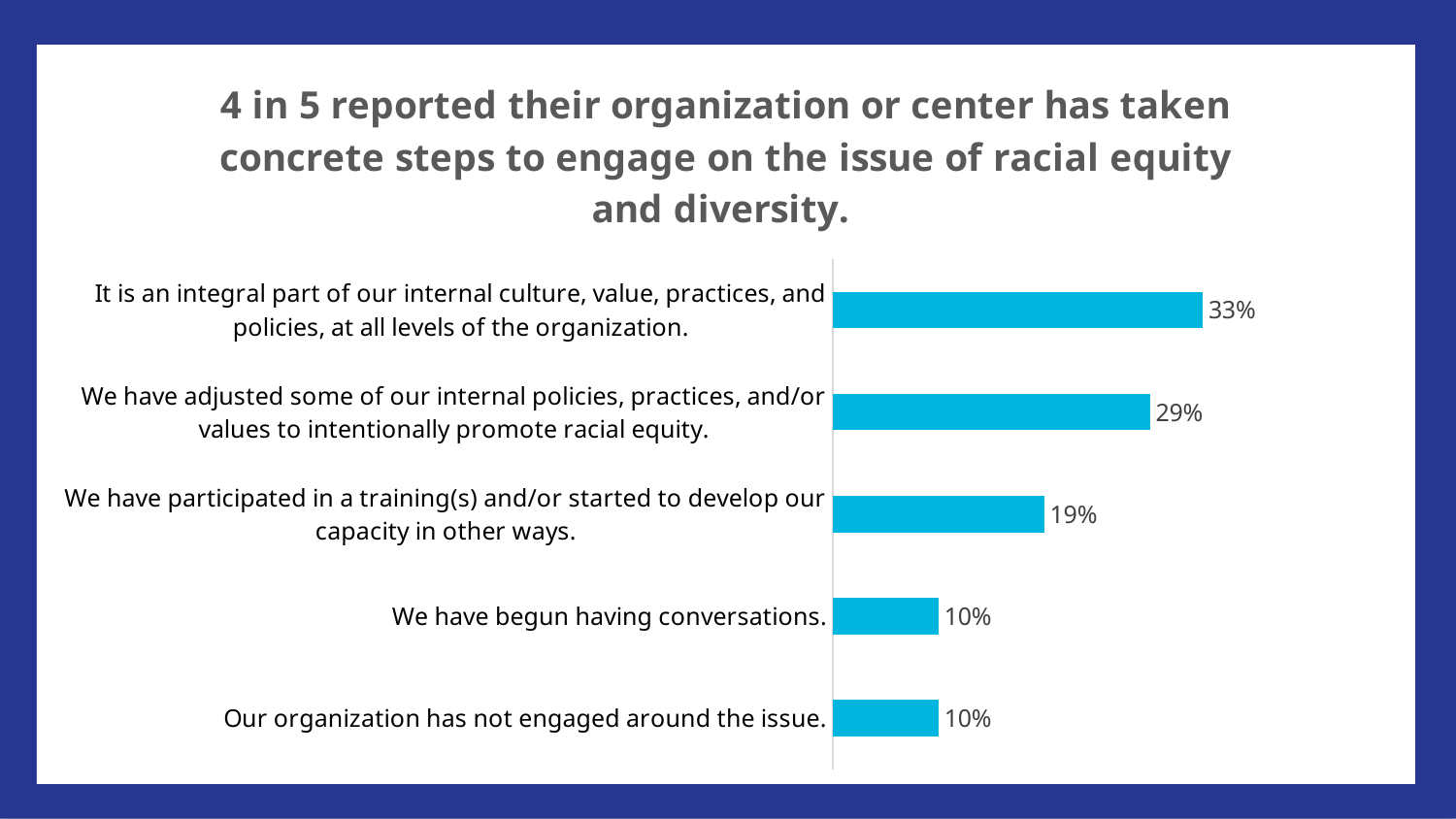
Which is larger: the value for 'We have participated in a training(s)...' or the value for 'We have begun having conversations.'? We have participated in a training(s) and/or started to develop our capacity in other ways. What is the title of the slide? 4 in 5 reported their organization or center has taken concrete steps to engage on the issue of racial equity and diversity. What kind of chart is shown on the slide? Bar chart What percentage reported that racial equity is an integral part of their internal culture, value, practices, and policies, at all levels of the organization? 33% How many categories are shown in the chart? 5 What is the difference between the value for 'It is an integral part of our internal culture...' and the value for 'We have adjusted some of our internal policies...'? 4% What percentage reported they have participated in a training(s) and/or started to develop their capacity in other ways? 19% What percentage reported their organization has not engaged around the issue? 10% Which category has the highest value? It is an integral part of our internal culture, value, practices, and policies, at all levels of the organization. Which two categories share the same value of 10%? We have begun having conversations; Our organization has not engaged around the issue What is the difference between the value for 'We have adjusted some of our internal policies...' and the value for 'We have participated in a training(s)...'? 10% What percentage reported they have adjusted some of their internal policies, practices, and/or values to intentionally promote racial equity? 29%